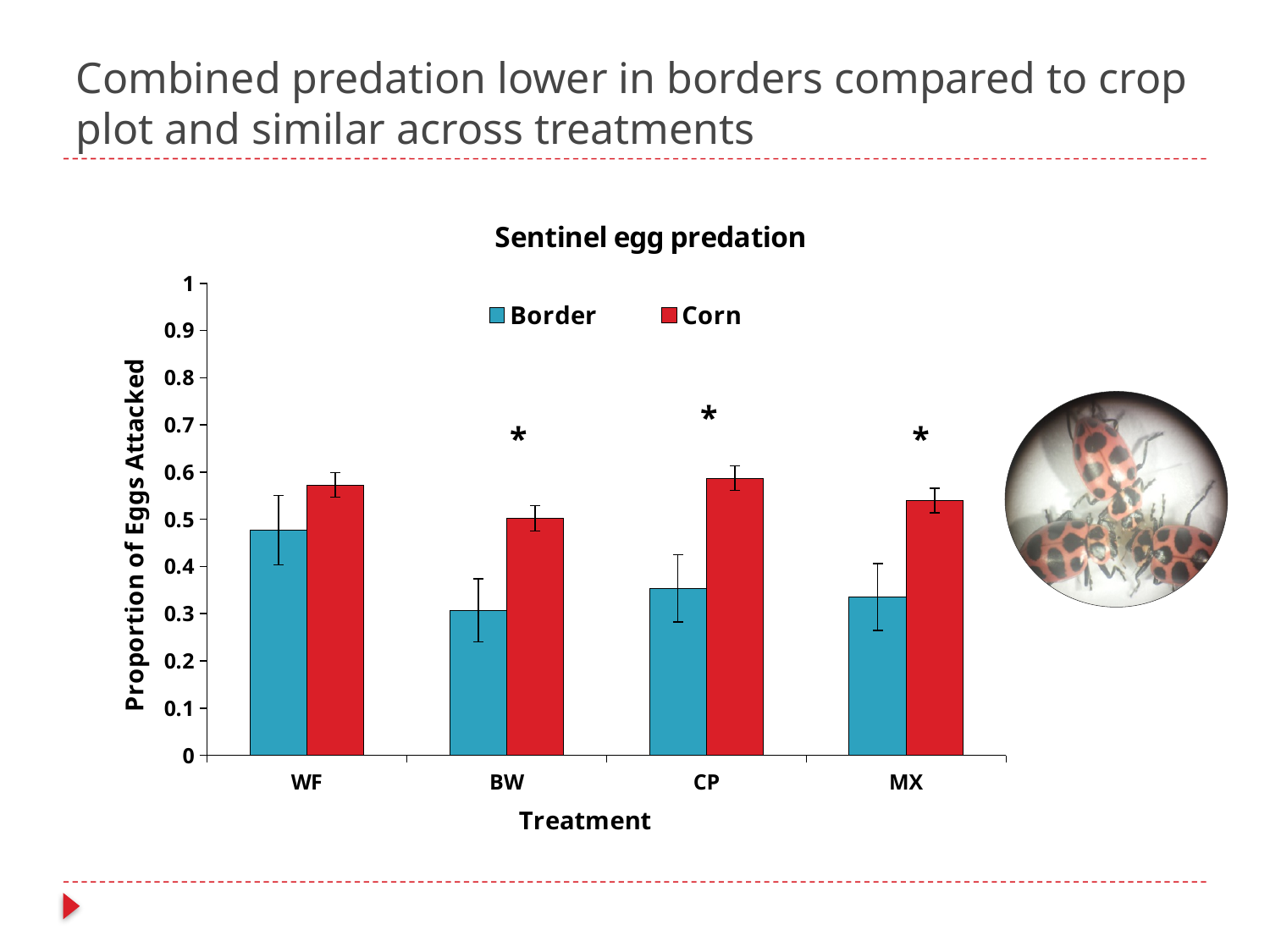
What is the label of the y axis? Proportion of Eggs Attacked Is the Border value for CP greater or less than 0.4? less How many series does the legend list? 2 For the WF treatment, which is larger, Border or Corn? Corn Which treatment has the highest Border value? WF Is the Corn value for CP greater or less than 0.5? greater How many treatment categories are shown on the x axis? 4 Is the Border value for WF greater or less than 0.4? greater For the BW treatment, which is larger, Border or Corn? Corn What is the title of the chart? Sentinel egg predation What kind of chart is shown on the slide? bar chart